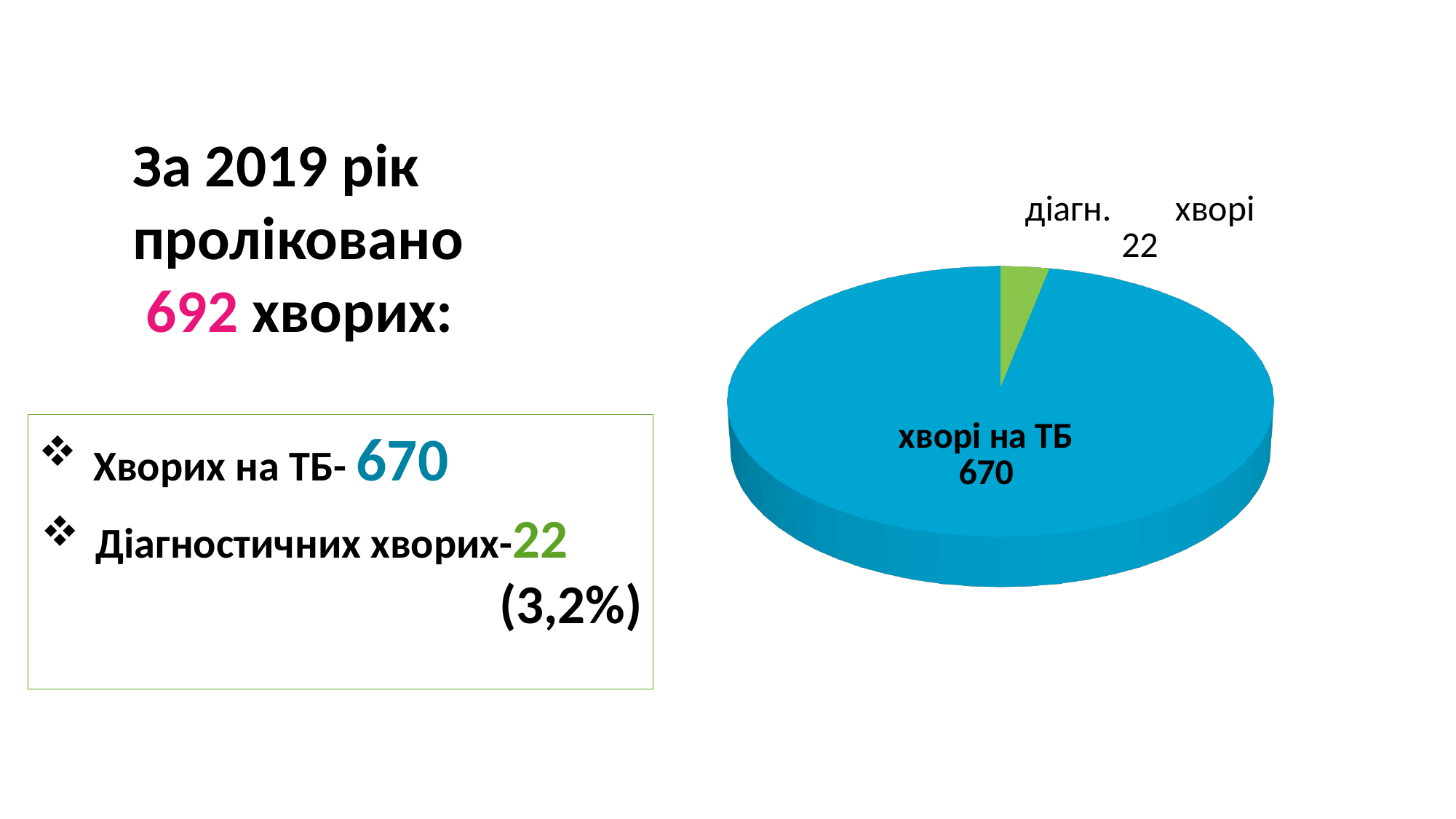
What is the total of the two slices in the pie chart? 692 What type of chart is shown on the slide? pie chart What colour is the slice for "діагн. хворі"? green Which slice of the pie chart is the largest? хворі на ТБ What colour is the slice for "хворі на ТБ"? blue What is the value for the slice labelled "діагн. хворі"? 22 What is the difference between the values for "хворі на ТБ" and "діагн. хворі"? 648 How many slices does the pie chart have? 2 What share of the pie does the "діагн. хворі" slice represent? 3,2% Which is larger, the value for "хворі на ТБ" or the value for "діагн. хворі"? хворі на ТБ Which slice of the pie chart is the smallest? діагн. хворі What is the value for the slice labelled "хворі на ТБ"? 670